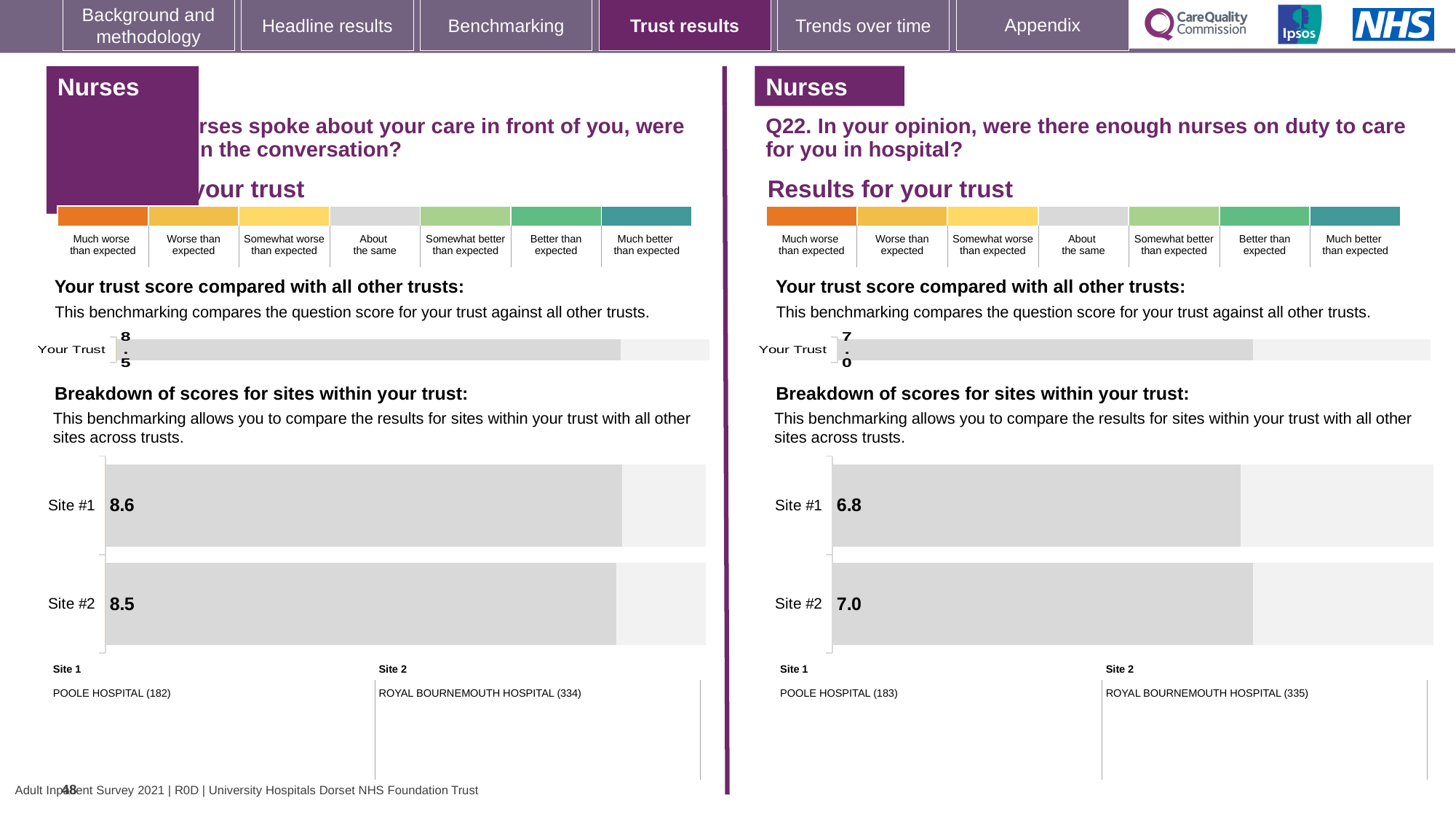
How many sites are shown in the right-hand (Q22) site breakdown chart? 2 In the left-hand 'Breakdown of scores for sites within your trust' chart, what is the score for Site #2? 8.5 In the left-hand 'Breakdown of scores for sites within your trust' chart, what is the score for Site #1? 8.6 In the right-hand (Q22) 'Breakdown of scores for sites within your trust' chart, what is the score for Site #1? 6.8 In the right-hand (Q22) site breakdown chart, what is the difference between the Site #2 and Site #1 scores? 0.2 In the left-hand 'Your trust score compared with all other trusts' chart, what is the score for Your Trust? 8.5 In the right-hand (Q22) 'Your trust score compared with all other trusts' chart, what is the score for Your Trust? 7.0 What kind of chart is used for the site breakdown on the left-hand side of the slide? Bar chart In the right-hand (Q22) site breakdown chart, which site has the higher score? Site #2 Which site is Site 1 in the right-hand (Q22) site breakdown chart? POOLE HOSPITAL (183) In the right-hand (Q22) 'Breakdown of scores for sites within your trust' chart, what is the score for Site #2? 7.0 In the left-hand site breakdown chart, what is the difference between the Site #1 and Site #2 scores? 0.1